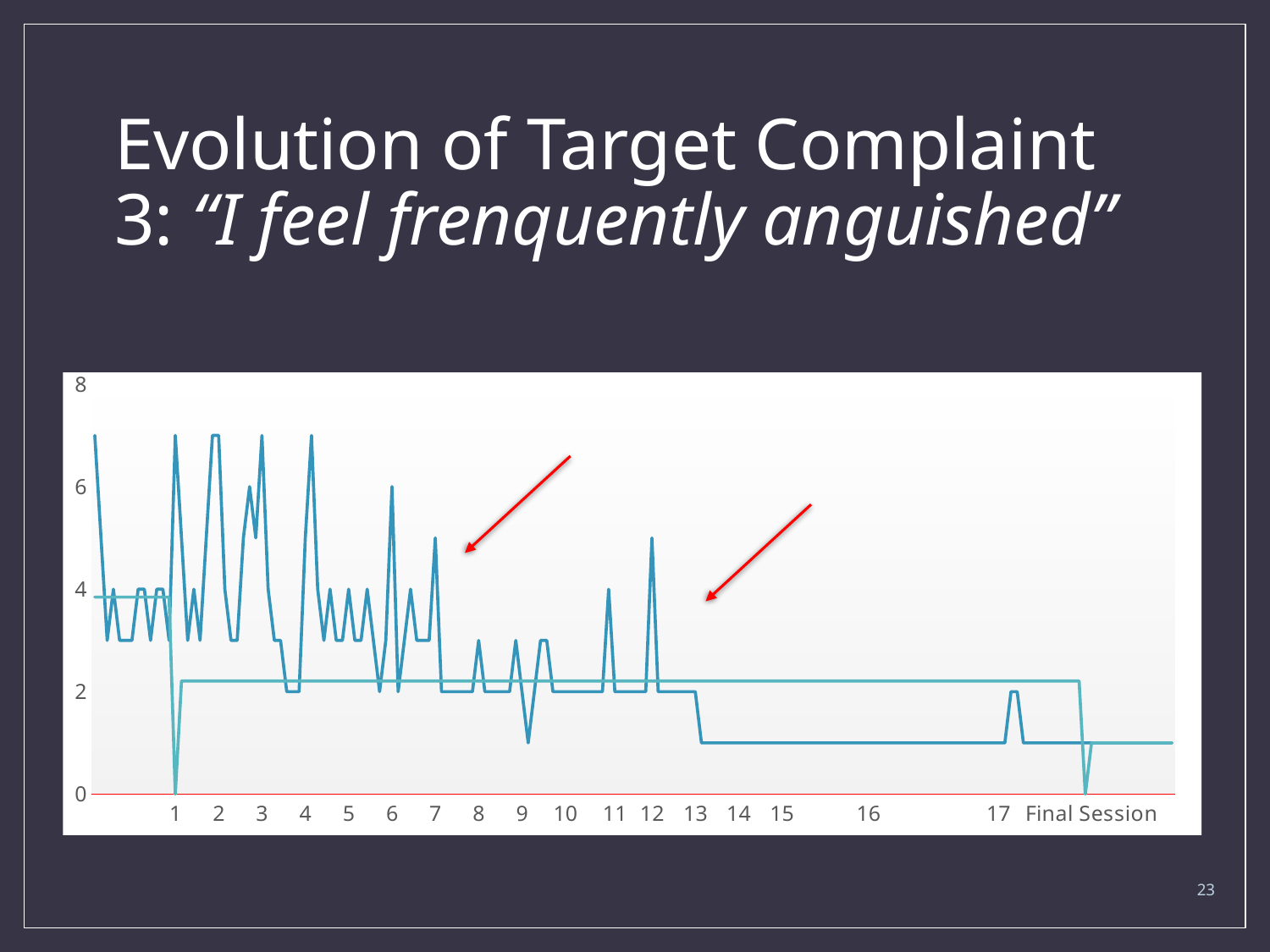
Is the value of the darker jagged line between sessions 14 and 16 greater or less than 2? less Is the value of the lighter line at the Final Session greater or less than 2? less Is the highest peak of the darker jagged line greater or less than 6? greater What is the label of the last point on the horizontal axis? Final Session Overall, do the plotted values rise or fall from session 1 to the Final Session? fall How many labels are shown along the horizontal axis? 18 What is the title of the slide containing the chart? Evolution of Target Complaint 3: "I feel frenquently anguished" What kind of chart is shown on the slide? line chart How many lines are plotted on the chart? 2 What is the highest value shown on the vertical axis? 8